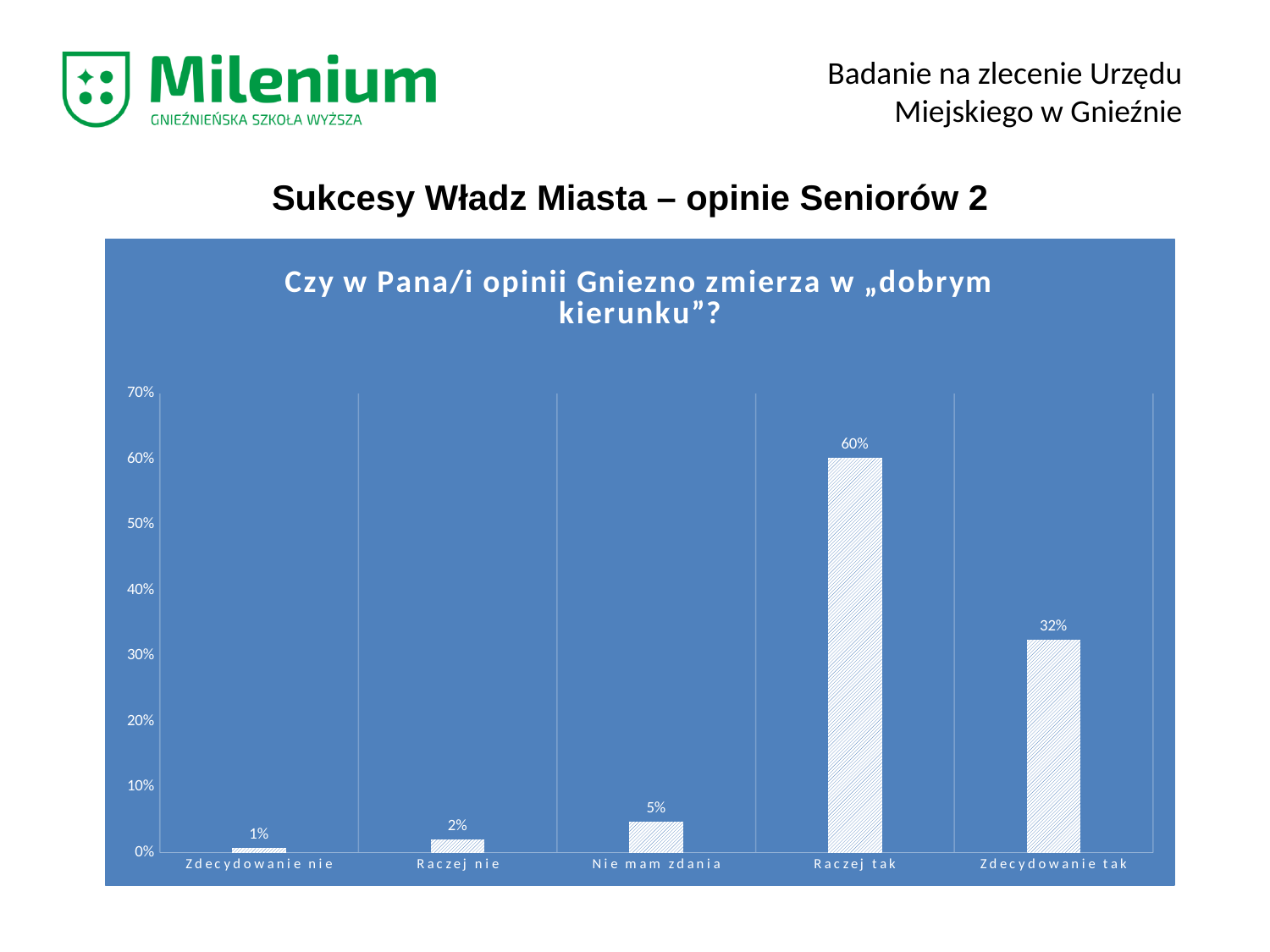
Which category has the lowest value? Zdecydowanie nie What is the value for "Zdecydowanie nie"? 1% How many categories are shown on the x axis? 5 What is the value for "Zdecydowanie tak"? 32% Which category has the highest value? Raczej tak What is the value for "Nie mam zdania"? 5% What is the title of the chart? Czy w Pana/i opinii Gniezno zmierza w „dobrym kierunku”? Which is larger, the value for "Raczej nie" or the value for "Nie mam zdania"? Nie mam zdania What kind of chart is shown on the slide? bar chart Is the value for "Zdecydowanie tak" greater or less than 40%? less What is the value for "Raczej tak"? 60% What is the difference between the values for "Raczej tak" and "Zdecydowanie tak"? 28%